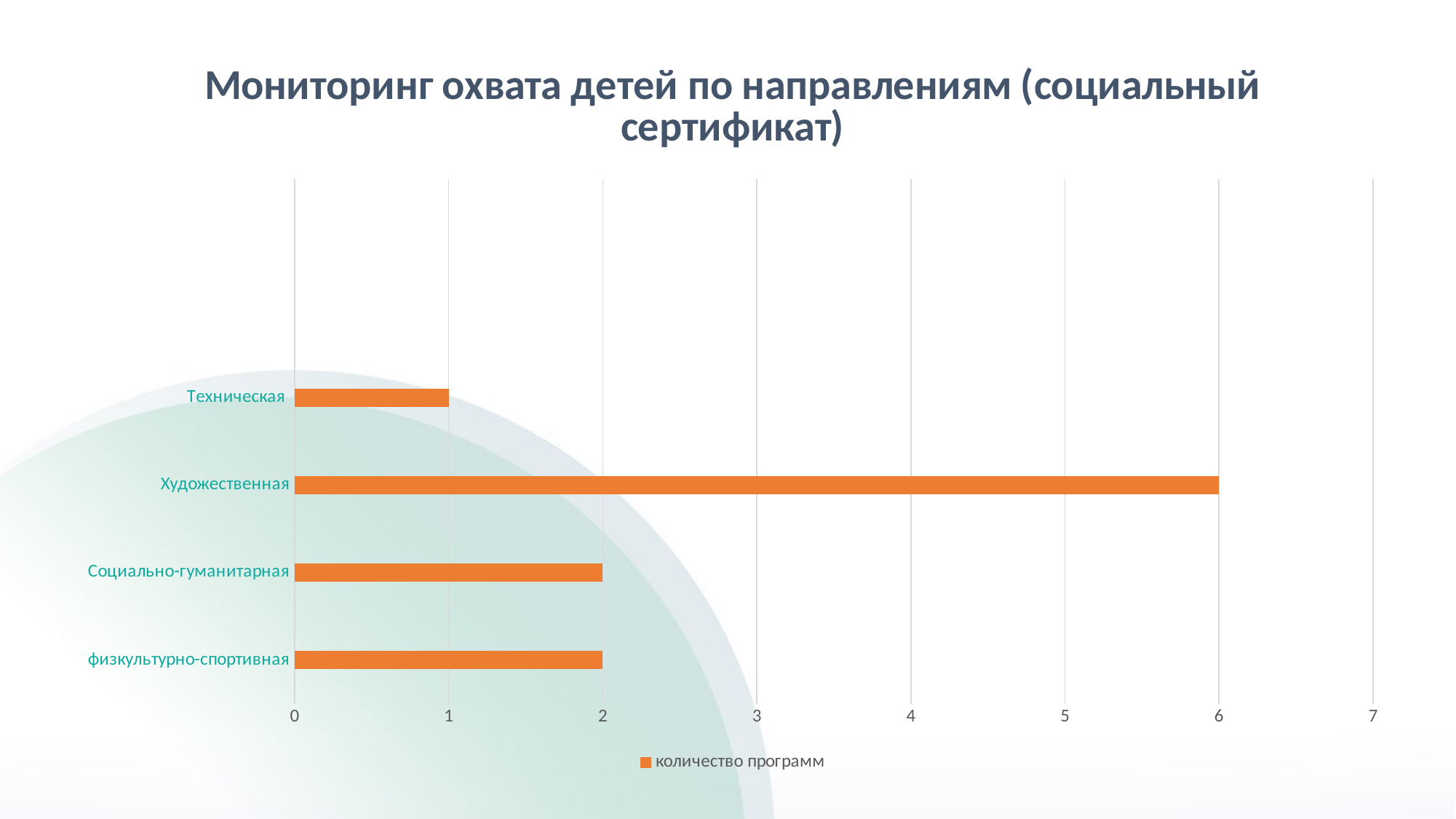
How many series does the legend list? 1 What is the difference between the values for Художественная and Техническая? 5 How many categories are shown on the chart? 4 Which category has the lowest value? Техническая Which is larger, the value for Художественная or the value for физкультурно-спортивная? Художественная What is the value for Художественная? 6 What is the value for Техническая? 1 Which category has the highest value? Художественная What kind of chart is shown on the slide? bar chart What is the legend entry of the chart? количество программ Is the value for Художественная greater or less than 5? greater What is the value for Социально-гуманитарная? 2